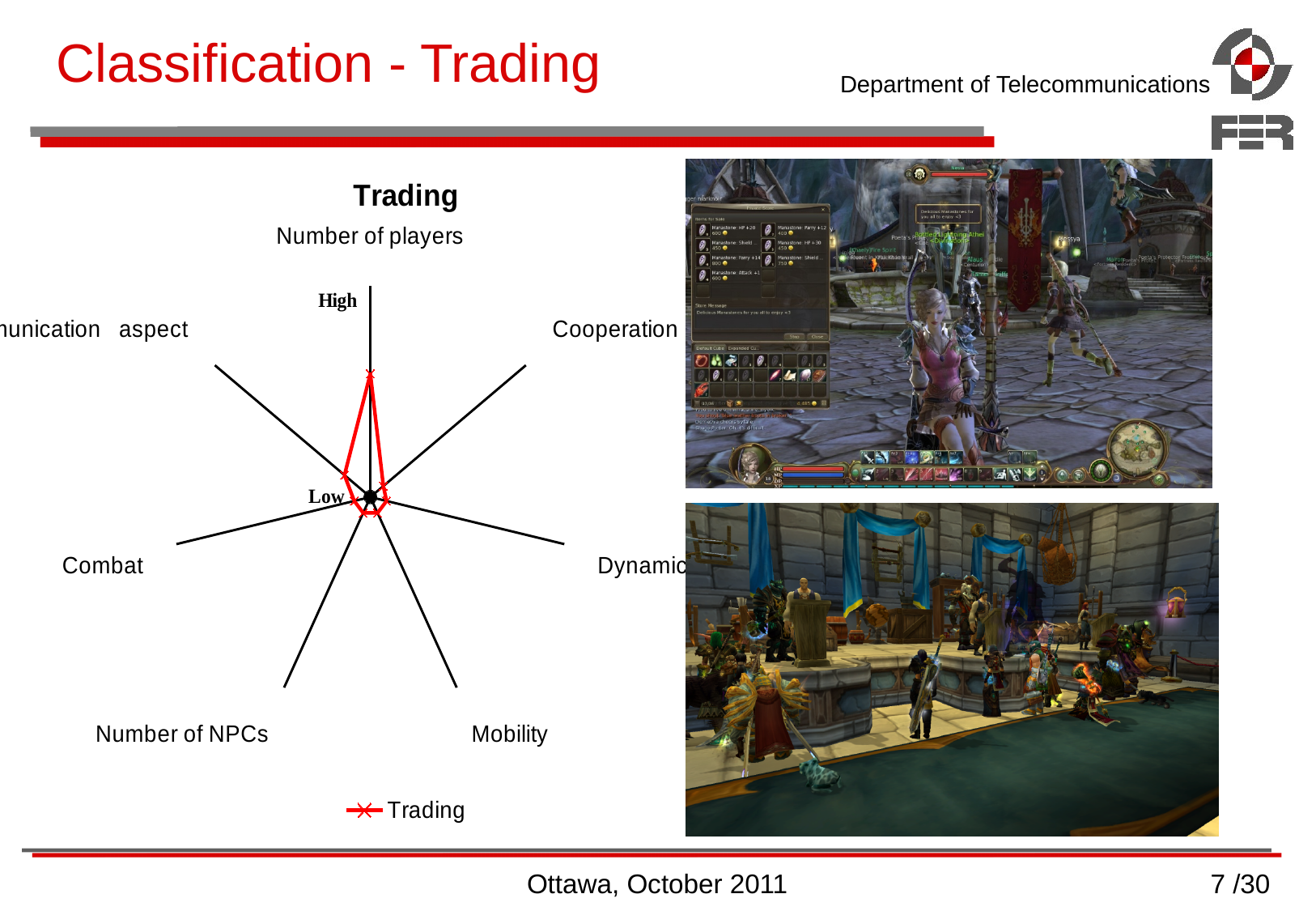
How many series does the chart legend list? 1 Which is larger for the Trading series: the value for Number of players or the value for Mobility? Number of players What is the name of the series shown in the legend? Trading What are the two scale labels printed along the vertical axis of the radar chart? High and Low Which is larger for the Trading series: the value for Number of players or the value for Number of NPCs? Number of players Which is larger for the Trading series: the value for Number of players or the value for Combat? Number of players What kind of chart is shown on the slide? Radar chart What is the title of the chart? Trading How many axes (categories) does the radar chart have? 7 On which axis does the Trading series reach its highest value? Number of players